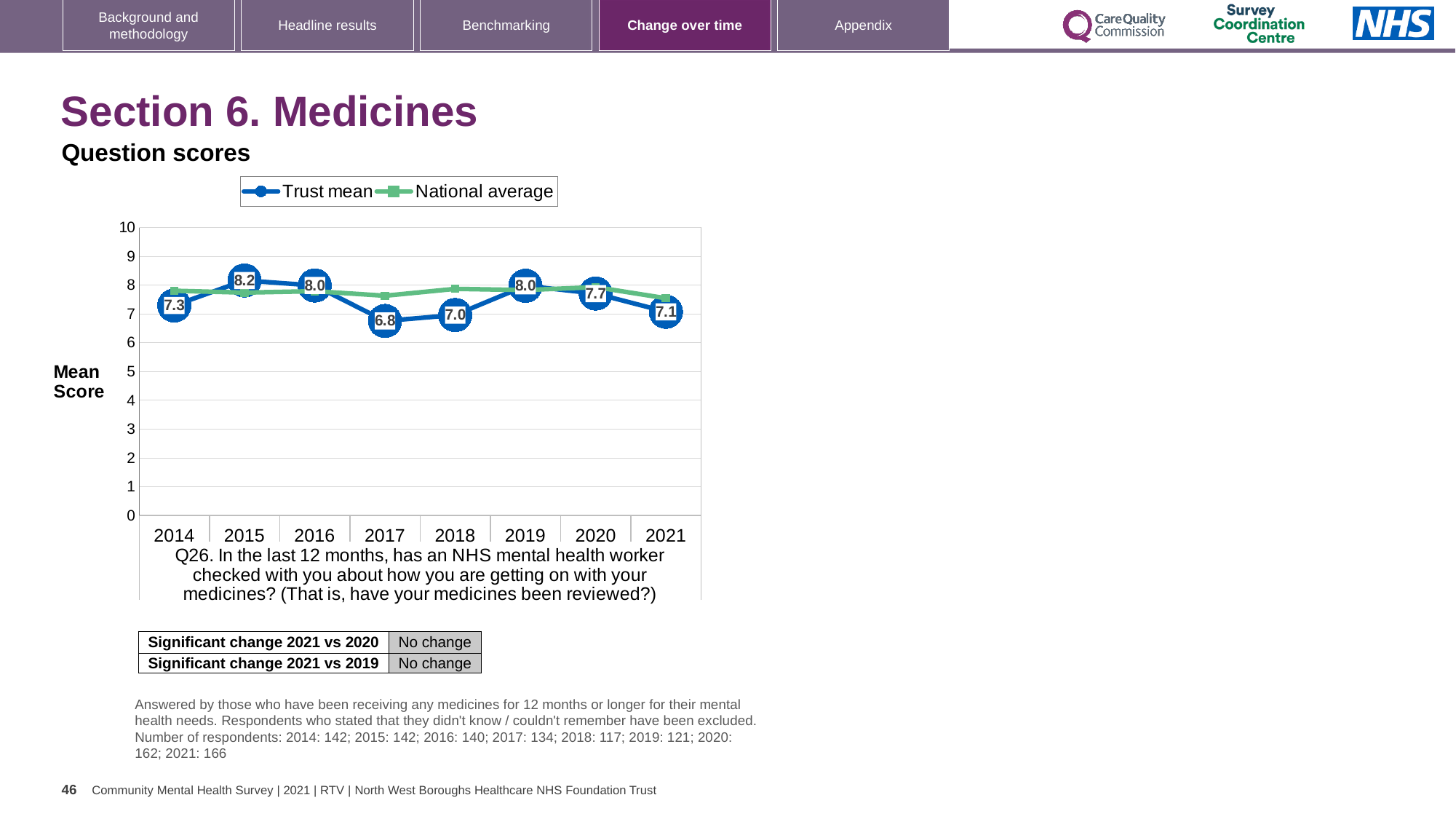
How many series does the legend list? 2 What kind of chart is shown on the slide? Line chart What is the Trust mean score for 2017? 6.8 What is the Trust mean score for 2015? 8.2 Is the National average for 2018 greater or less than 7? greater What is the Trust mean score for 2021? 7.1 What is the difference between the Trust mean score in 2015 and in 2017? 1.4 How many years are plotted on the x axis? 8 Which is larger, the Trust mean score in 2020 or in 2021? 2020 In which year is the Trust mean score highest? 2015 In which year is the Trust mean score lowest? 2017 Does the Trust mean score rise or fall from 2019 to 2021? Fall